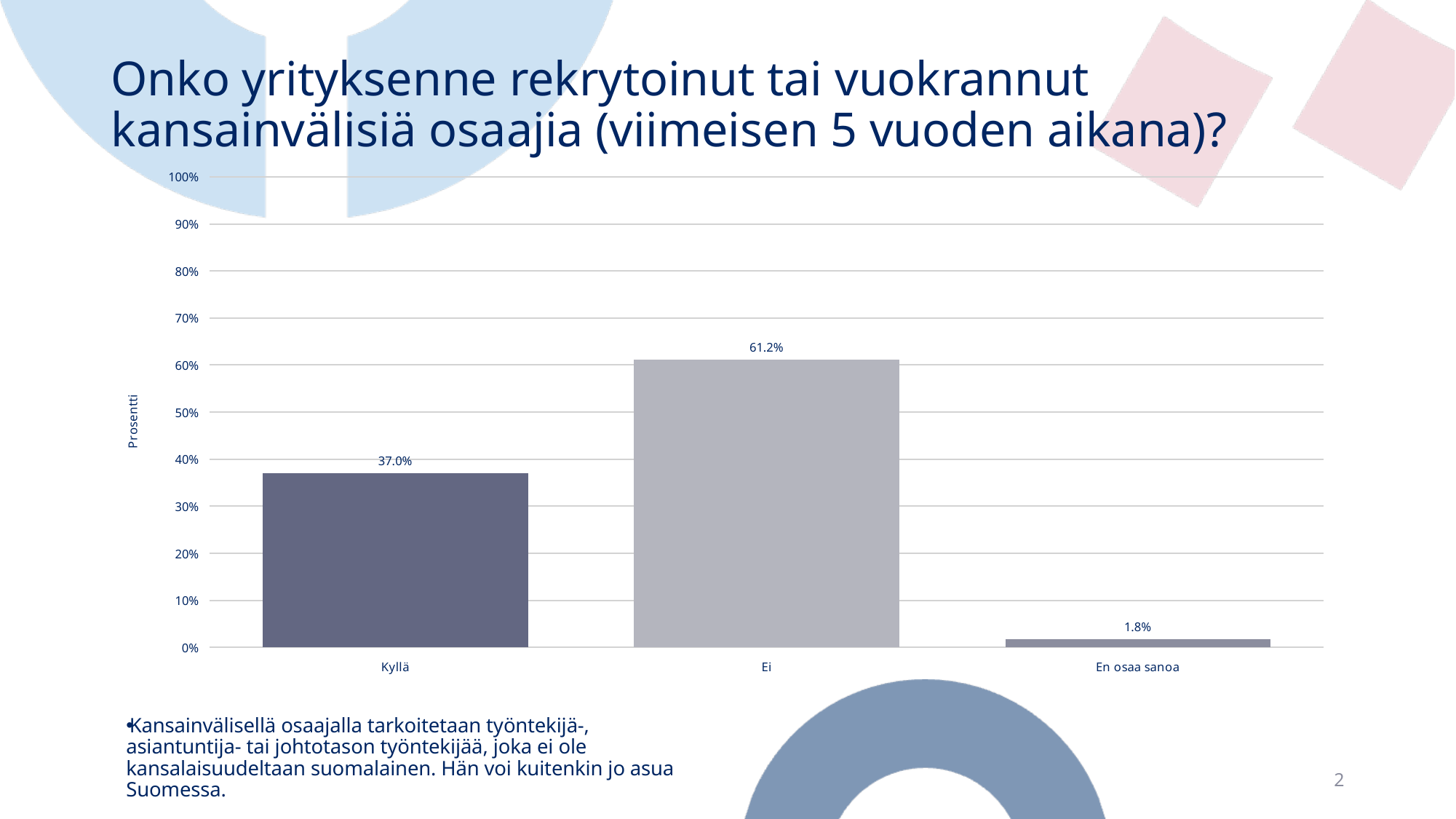
Which category has the lowest value? En osaa sanoa What is the value for Kyllä? 37.0% What is the value for En osaa sanoa? 1.8% Is the value for Kyllä greater or less than 40%? less Is the value for Ei greater or less than 60%? greater How many categories are shown on the x axis? 3 What is the difference between the values for Ei and Kyllä? 24.2% Which is larger, the value for Kyllä or the value for Ei? Ei Which category has the highest value? Ei What is the label of the vertical axis? Prosentti What is the value for Ei? 61.2% What kind of chart is shown on the slide? bar chart